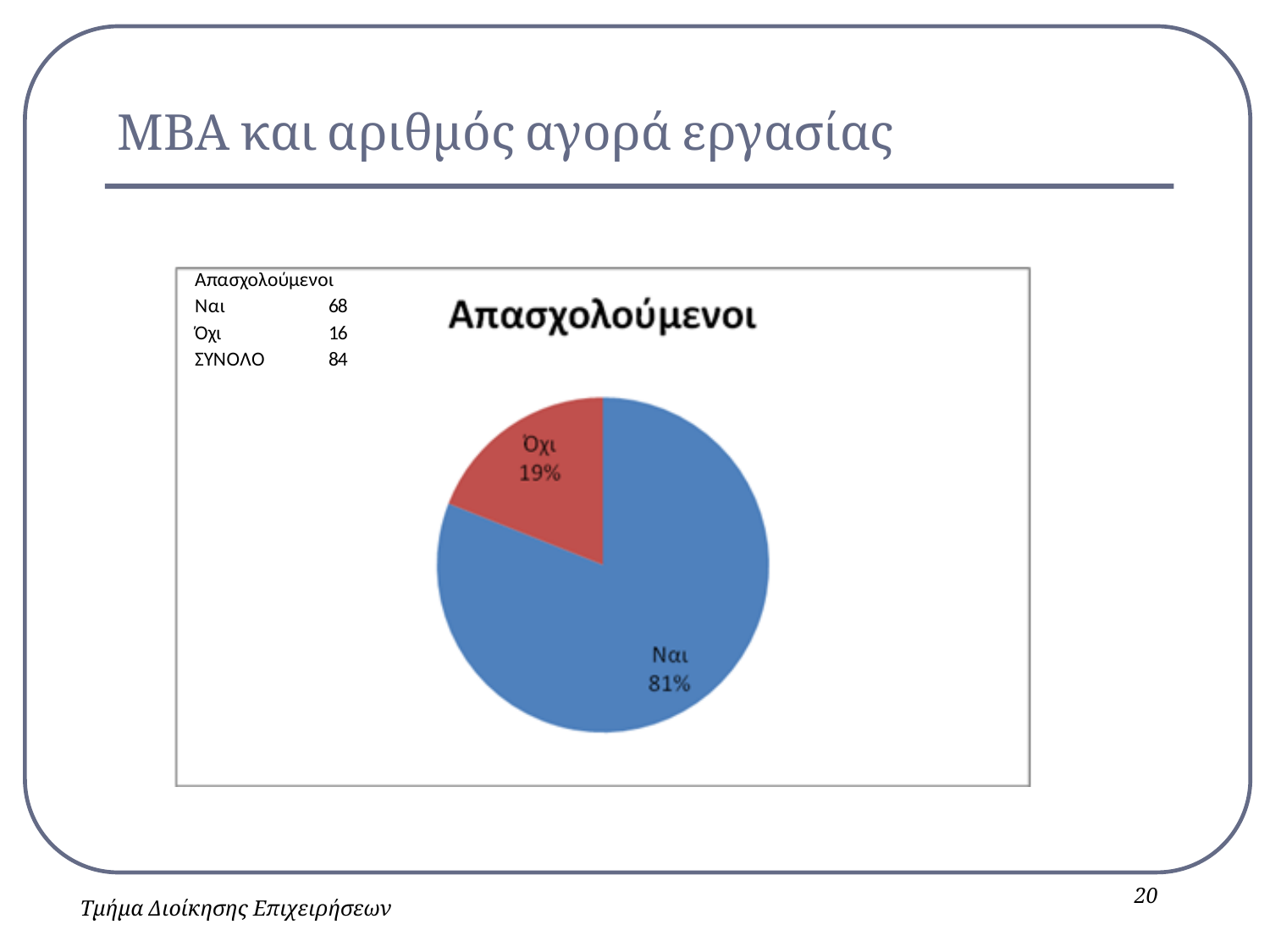
Which is larger, the 'Ναι' slice or the 'Όχι' slice? Ναι According to the data table on the slide, how many respondents answered 'Όχι'? 16 What is the difference in percentage points between the 'Ναι' and 'Όχι' slices? 62 What share of the pie does the 'Ναι' slice represent? 81% How many slices does the pie chart have? 2 According to the data table on the slide, how many respondents answered 'Ναι'? 68 What kind of chart is shown on the slide? pie chart What is the title of the chart? Απασχολούμενοι Which slice of the pie is the largest? Ναι What share of the pie does the 'Όχι' slice represent? 19% What colour is the 'Όχι' slice of the pie? red Which slice of the pie is the smallest? Όχι